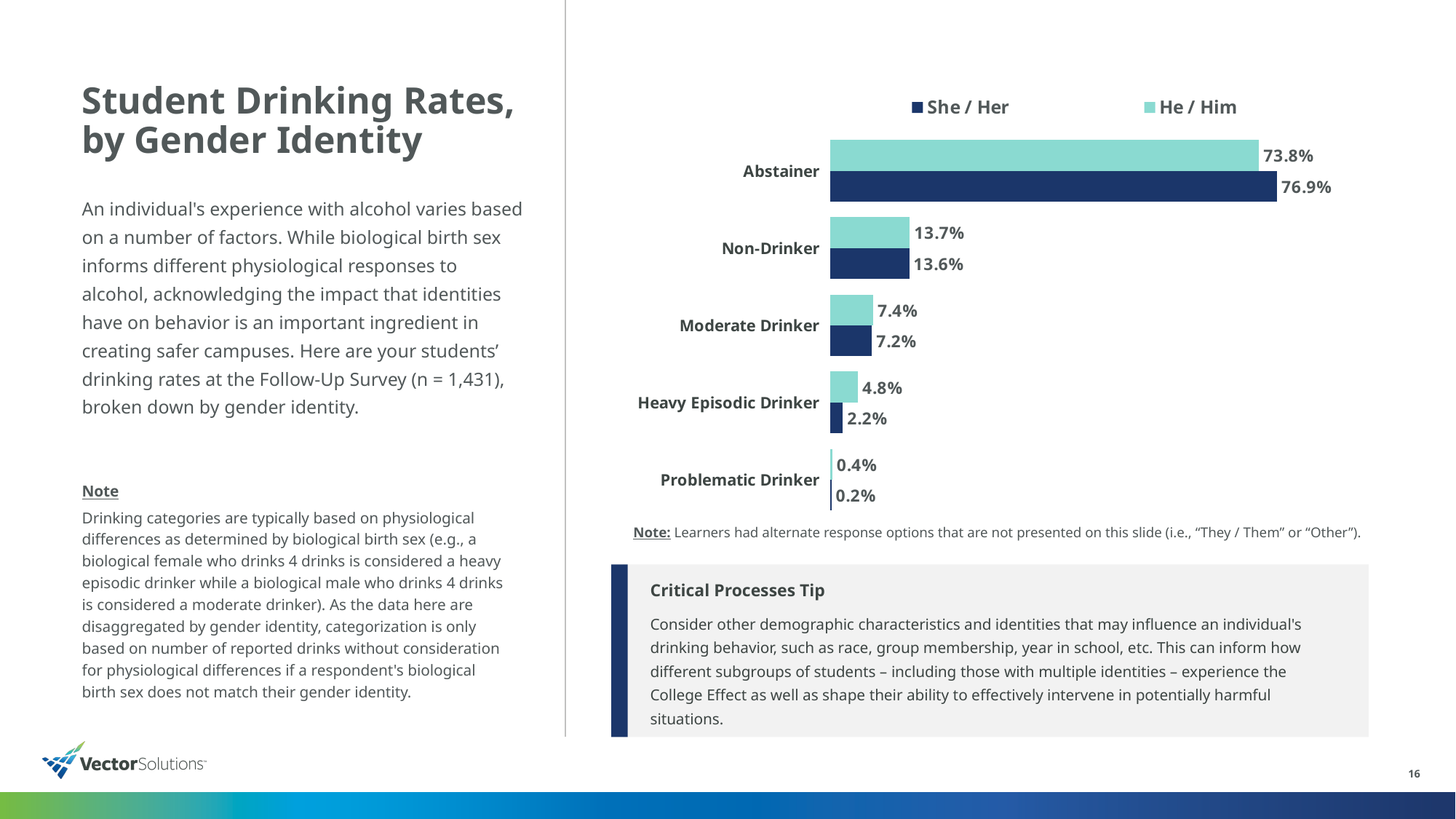
Which category has the highest He / Him value? Abstainer What kind of chart is shown on the slide? Bar chart What is the He / Him value for Problematic Drinker? 0.4% Which is larger for Moderate Drinker, the She / Her value or the He / Him value? He / Him How many series does the legend list? 2 What is the He / Him value for Heavy Episodic Drinker? 4.8% What is the difference between the He / Him and She / Her values for Heavy Episodic Drinker? 2.6% What is the difference between the She / Her and He / Him values for Abstainer? 3.1% Which category has the lowest She / Her value? Problematic Drinker What is the She / Her value for Abstainer? 76.9% What is the She / Her value for Non-Drinker? 13.6% How many drinking categories are shown in the chart? 5